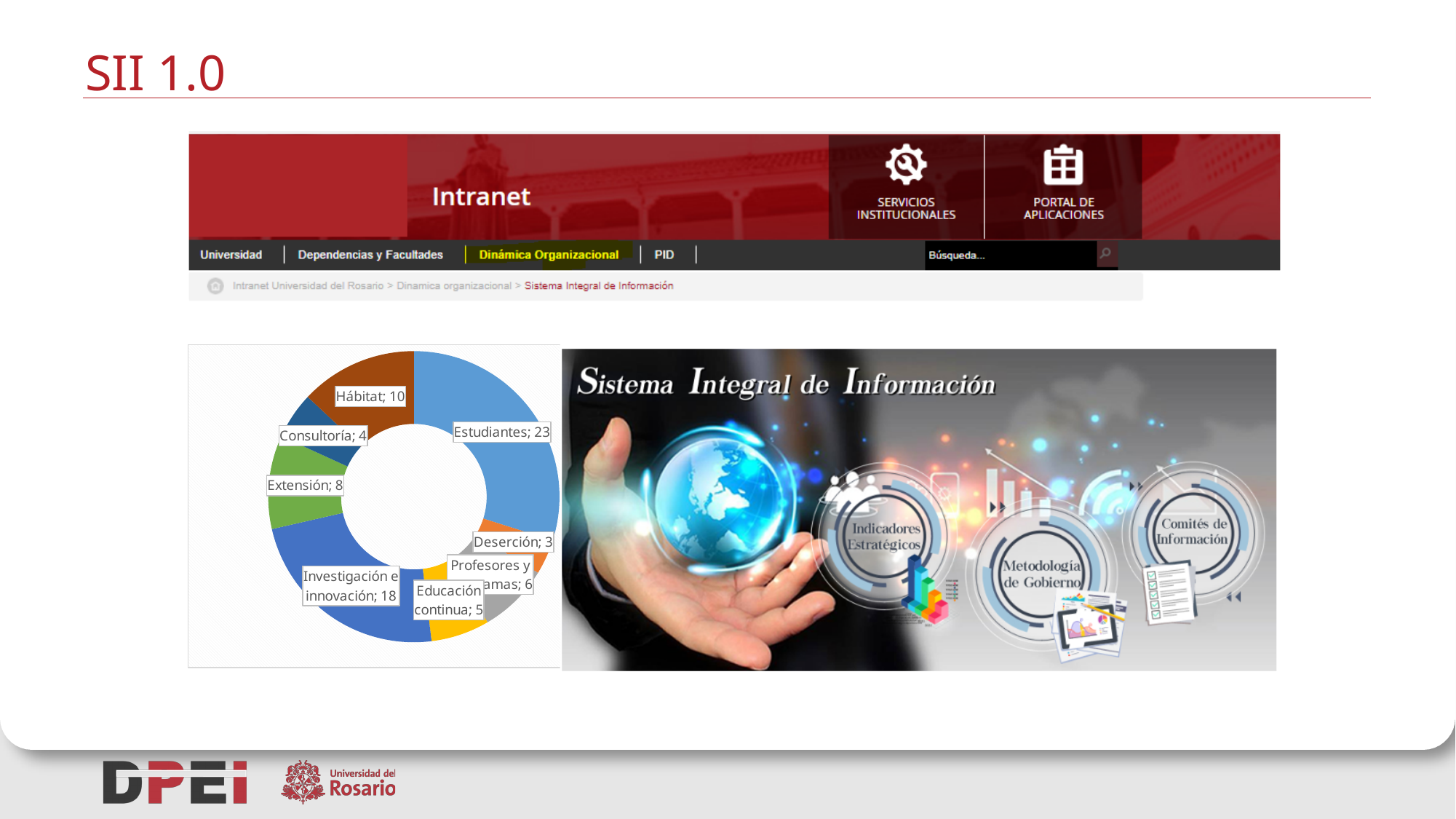
In the doughnut chart, what is the value for Educación continua? 5 In the doughnut chart, what is the value for Investigación e innovación? 18 In the doughnut chart, what is the difference between the values for Hábitat and Extensión? 2 What kind of chart is shown on the left of the slide? Doughnut (pie) chart In the doughnut chart, which is larger: Hábitat or Extensión? Hábitat In the doughnut chart, what is the difference between the values for Estudiantes and Investigación e innovación? 5 In the doughnut chart, what is the value for Extensión? 8 In the doughnut chart, what is the value for Consultoría? 4 In the doughnut chart, what is the value for Hábitat? 10 In the doughnut chart, what is the value for Deserción? 3 In the doughnut chart, what is the value for Estudiantes? 23 In the doughnut chart, which category has the highest value? Estudiantes